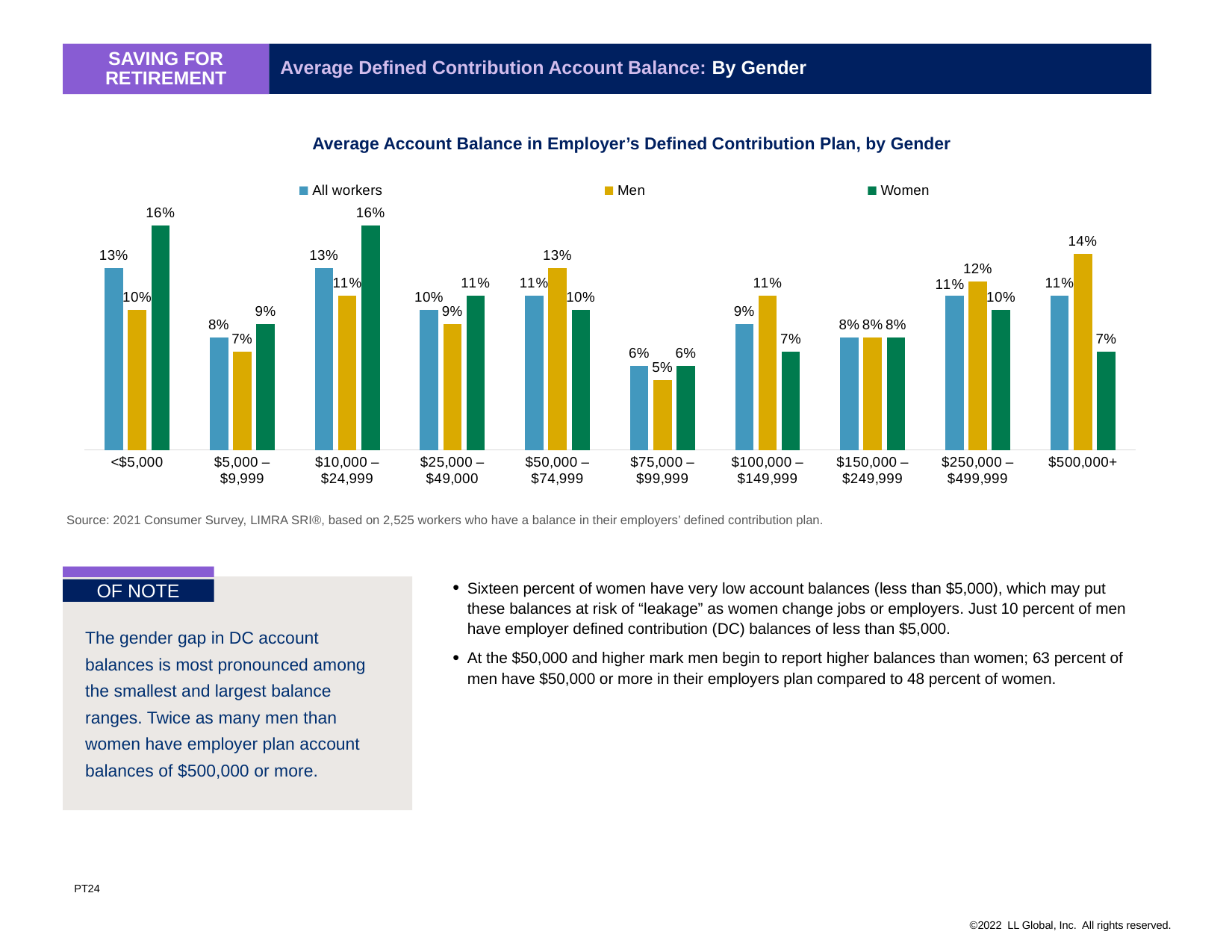
What is the value for All workers in the $75,000 – $99,999 category? 6% What percentage of men have an account balance of $500,000 or more? 14% What is the difference between the Women and Men values in the $500,000+ category? 7% In the $100,000 – $149,999 category, which is larger: the value for Men or the value for Women? Men What percentage of women have an account balance of less than $5,000? 16% How many balance categories are shown on the x axis? 10 What is the difference between the Women and Men values in the <$5,000 category? 6% Which balance category has the highest value for Men? $500,000+ What kind of chart is shown on the slide? Bar chart Which balance category has the lowest value for Men? $75,000 – $99,999 Which series is shown in green in the legend? Women How many series does the legend list? 3